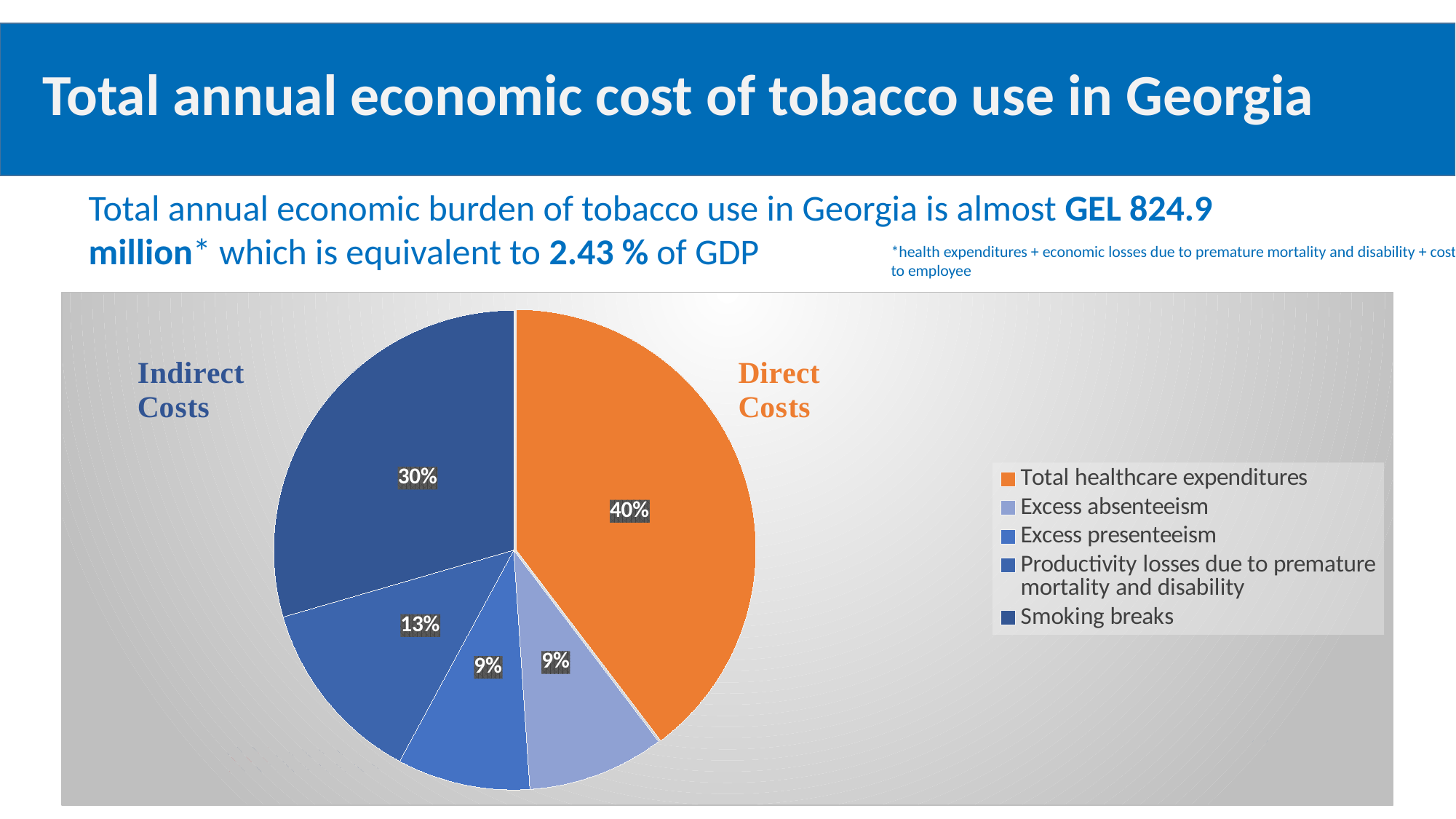
What share of the pie is Total healthcare expenditures? 40% Which category has the largest slice of the pie? Total healthcare expenditures What is the difference in percentage points between Total healthcare expenditures and Smoking breaks? 10 Which is larger, the slice for Smoking breaks or the slice for Productivity losses due to premature mortality and disability? Smoking breaks What share of the pie is Smoking breaks? 30% What share of the pie is Excess absenteeism? 9% What colour is the Direct Costs slice of the pie? orange What kind of chart is shown on the slide? pie chart How many slices does the pie chart have? 5 How many entries does the legend of the pie chart list? 5